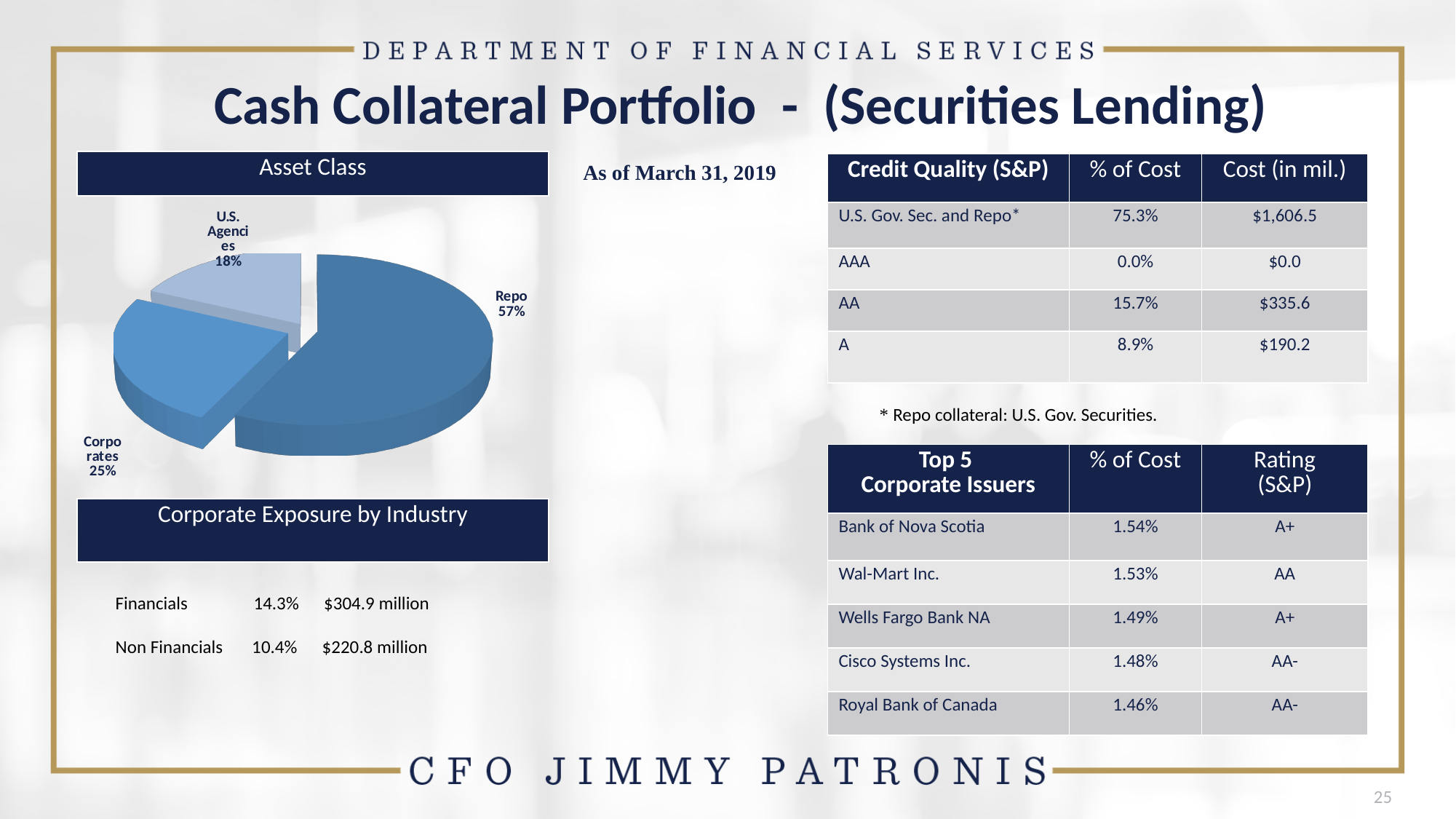
What kind of chart is the Asset Class chart? pie chart Which asset class has the smallest slice in the Asset Class pie chart? U.S. Agencies In the Asset Class pie chart, what share do Corporates have? 25% In the Asset Class pie chart, what share does Repo have? 57% In the Asset Class pie chart, what share do U.S. Agencies have? 18% In the Asset Class pie chart, what is the combined share of Corporates and U.S. Agencies? 43% In the Asset Class pie chart, which is larger: Corporates or U.S. Agencies? Corporates In the Asset Class pie chart, what is the difference in percentage points between Repo and Corporates? 32 In the Asset Class pie chart, what is the difference in percentage points between Corporates and U.S. Agencies? 7 How many slices does the Asset Class pie chart have? 3 What is the title of the pie chart on the slide? Asset Class Which asset class has the largest slice in the Asset Class pie chart? Repo